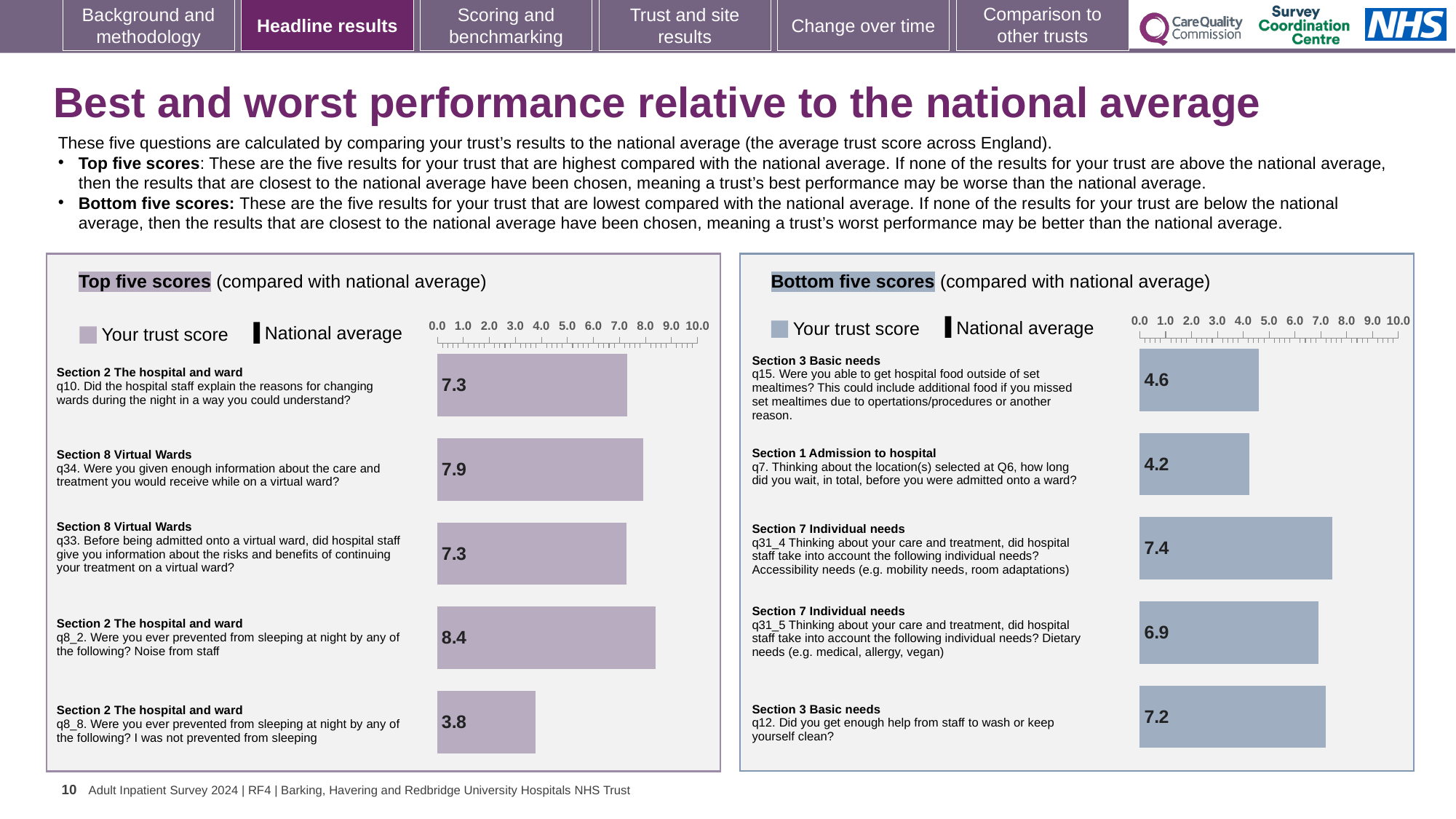
In the Bottom five scores chart, which question has the highest trust score? q31_4 (Accessibility needs) How many bars are plotted in the Top five scores chart? 5 In the Bottom five scores chart, what is the trust score for q12 about getting enough help from staff to wash or keep yourself clean? 7.2 In the Top five scores chart, what is the trust score for q34 about information on care and treatment while on a virtual ward? 7.9 What type of chart is used in the Bottom five scores panel? Bar chart In the Bottom five scores chart, what is the difference between the trust scores for q31_4 and q31_5? 0.5 In the Top five scores chart, which question has the highest trust score? q8_2 (Noise from staff) In the Bottom five scores chart, which has the larger trust score, q15 or q7? q15 In the Top five scores chart, which question has the lowest trust score? q8_8 (I was not prevented from sleeping) In the Bottom five scores chart, which question has the lowest trust score? q7 (wait before being admitted onto a ward) In the Top five scores chart, what is the difference between the trust scores for q8_2 and q8_8? 4.6 How many entries does the legend of the Top five scores chart list? 2